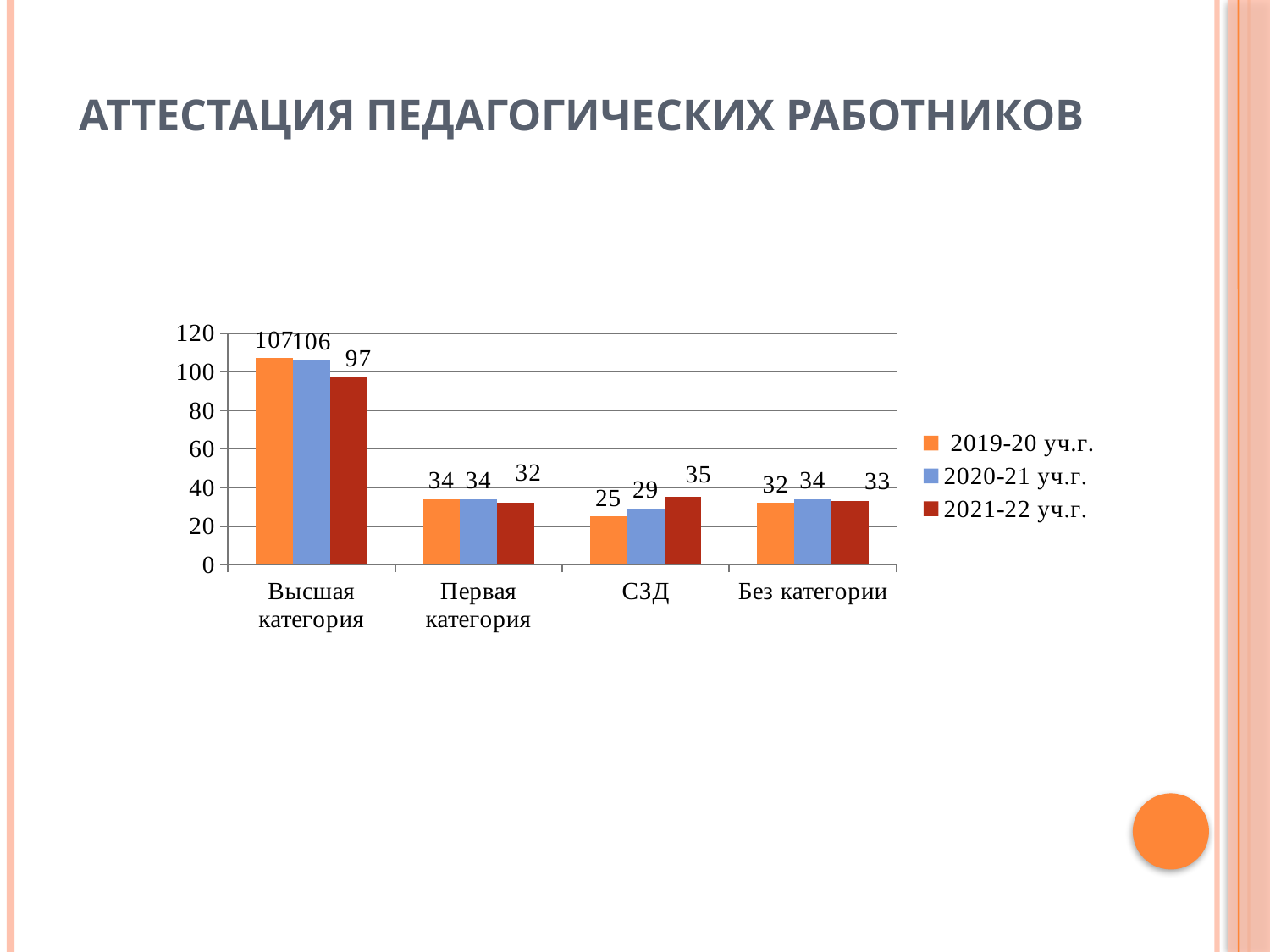
Do the values for Высшая категория rise or fall from 2019-20 уч.г. to 2021-22 уч.г.? fall What kind of chart is shown on the slide? bar chart Which is larger for СЗД: the 2019-20 уч.г. value or the 2021-22 уч.г. value? 2021-22 уч.г. How many series does the legend list? 3 What is the value for Без категории in the 2020-21 уч.г. series? 34 Which category has the lowest value in the 2019-20 уч.г. series? СЗД What is the value for СЗД in the 2021-22 уч.г. series? 35 What is the value for Высшая категория in the 2019-20 уч.г. series? 107 Is the value for Первая категория in the 2020-21 уч.г. series greater or less than 40? less How many categories are shown on the x axis? 4 What is the difference between the 2019-20 уч.г. and 2021-22 уч.г. values for Высшая категория? 10 Which category has the highest value in the 2021-22 уч.г. series? Высшая категория